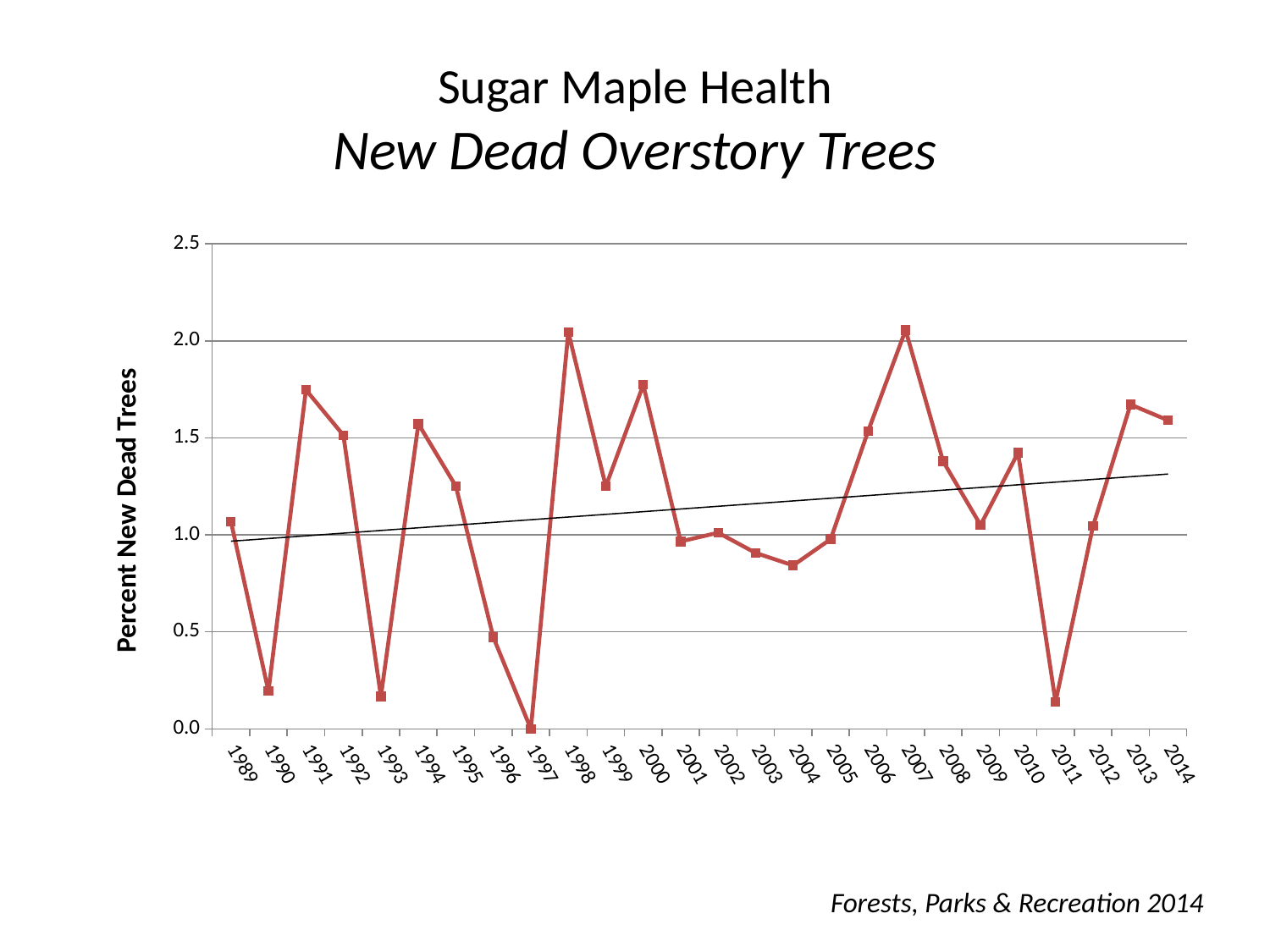
What is the percent of new dead trees in 1997? 0.0 Is the value for 1998 greater or less than 2.0? greater Which year has the higher value, 1990 or 1991? 1991 Which year has the lowest percent of new dead trees? 1997 Is the value for 2004 greater or less than 1.0? less Is the value for 1990 greater or less than 0.5? less Does the straight trend line rise or fall from 1989 to 2014? rise How many years are plotted on the x axis? 26 What kind of chart is shown on the slide? line chart Which year has the higher value, 2007 or 2009? 2007 What is the label on the y axis? Percent New Dead Trees